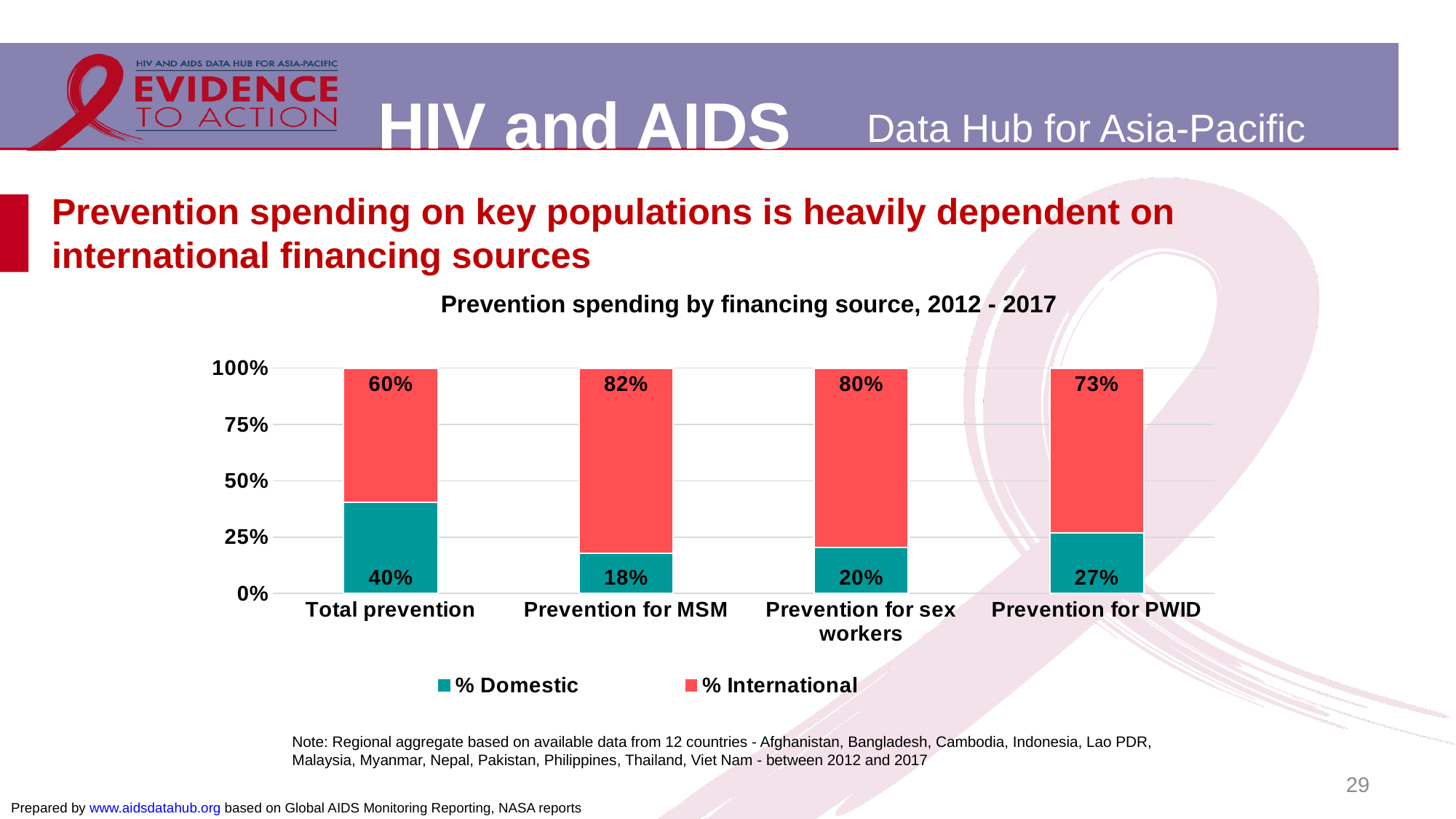
Which category has the highest % International share? Prevention for MSM What is the % International value for Prevention for MSM? 82% What is the % Domestic value for Prevention for sex workers? 20% What is the % Domestic value for Total prevention? 40% What is the % International value for Prevention for PWID? 73% Is the % Domestic value larger for Total prevention or for Prevention for sex workers? Total prevention How many series does the legend list? 2 Which category has the lowest % Domestic share? Prevention for MSM How many categories are shown on the x axis? 4 What kind of chart is shown? Stacked bar chart What is the difference between the % International and % Domestic values for Prevention for PWID? 46% What is the title of the chart? Prevention spending by financing source, 2012 - 2017